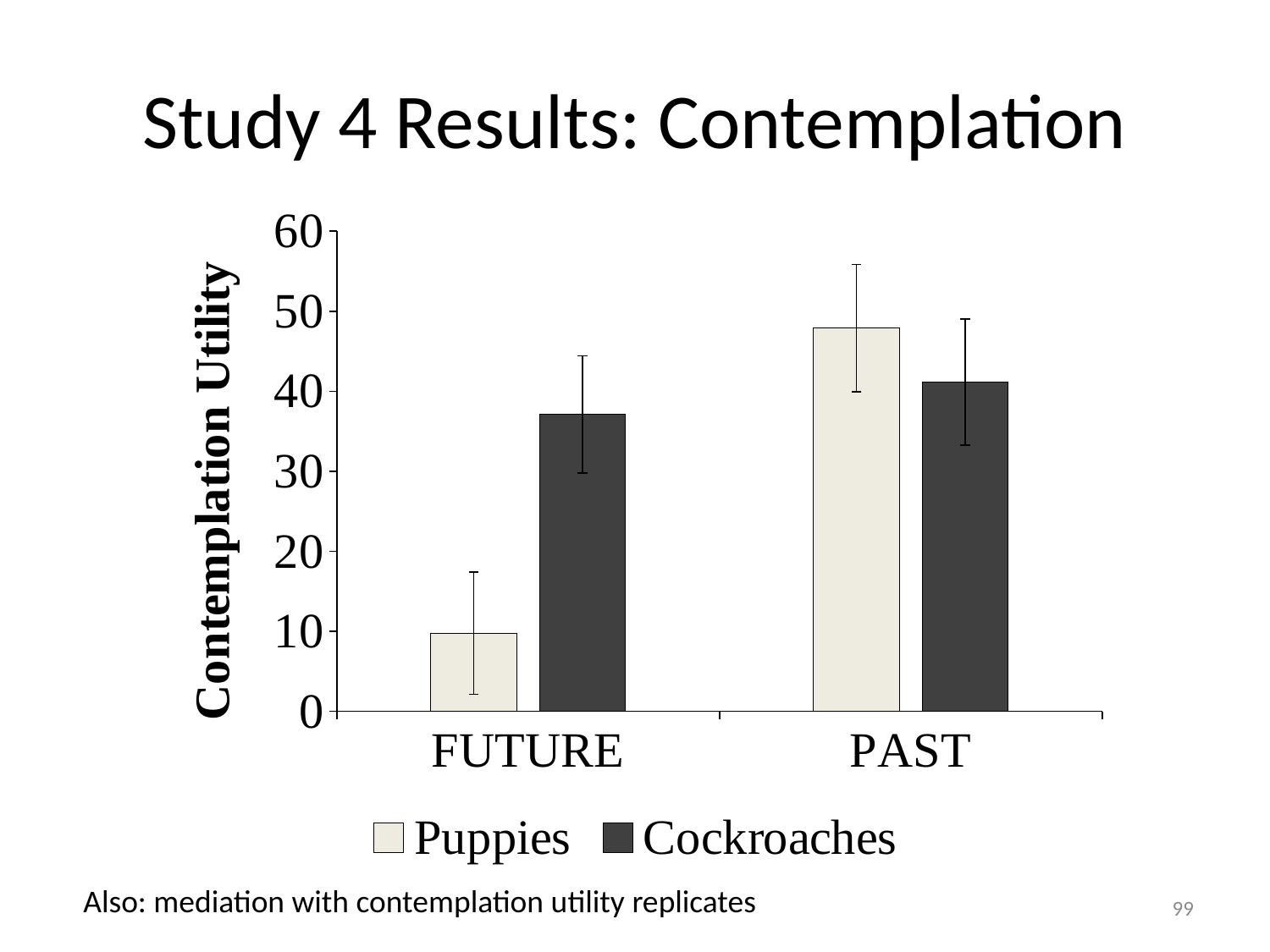
How many categories are shown on the x axis? 2 Is the value for Puppies in the FUTURE condition greater or less than 20? less How many series does the legend list? 2 What kind of chart is shown on the slide? bar chart In the FUTURE condition, which is larger: Puppies or Cockroaches? Cockroaches What is the label of the y axis? Contemplation Utility Is the value for Puppies in the PAST condition greater or less than 40? greater Which series and category combination has the highest contemplation utility? Puppies, PAST Is the value for Cockroaches in the FUTURE condition greater or less than 30? greater Which series and category combination has the lowest contemplation utility? Puppies, FUTURE Does the Puppies series rise or fall from FUTURE to PAST? rise In the PAST condition, which is larger: Puppies or Cockroaches? Puppies